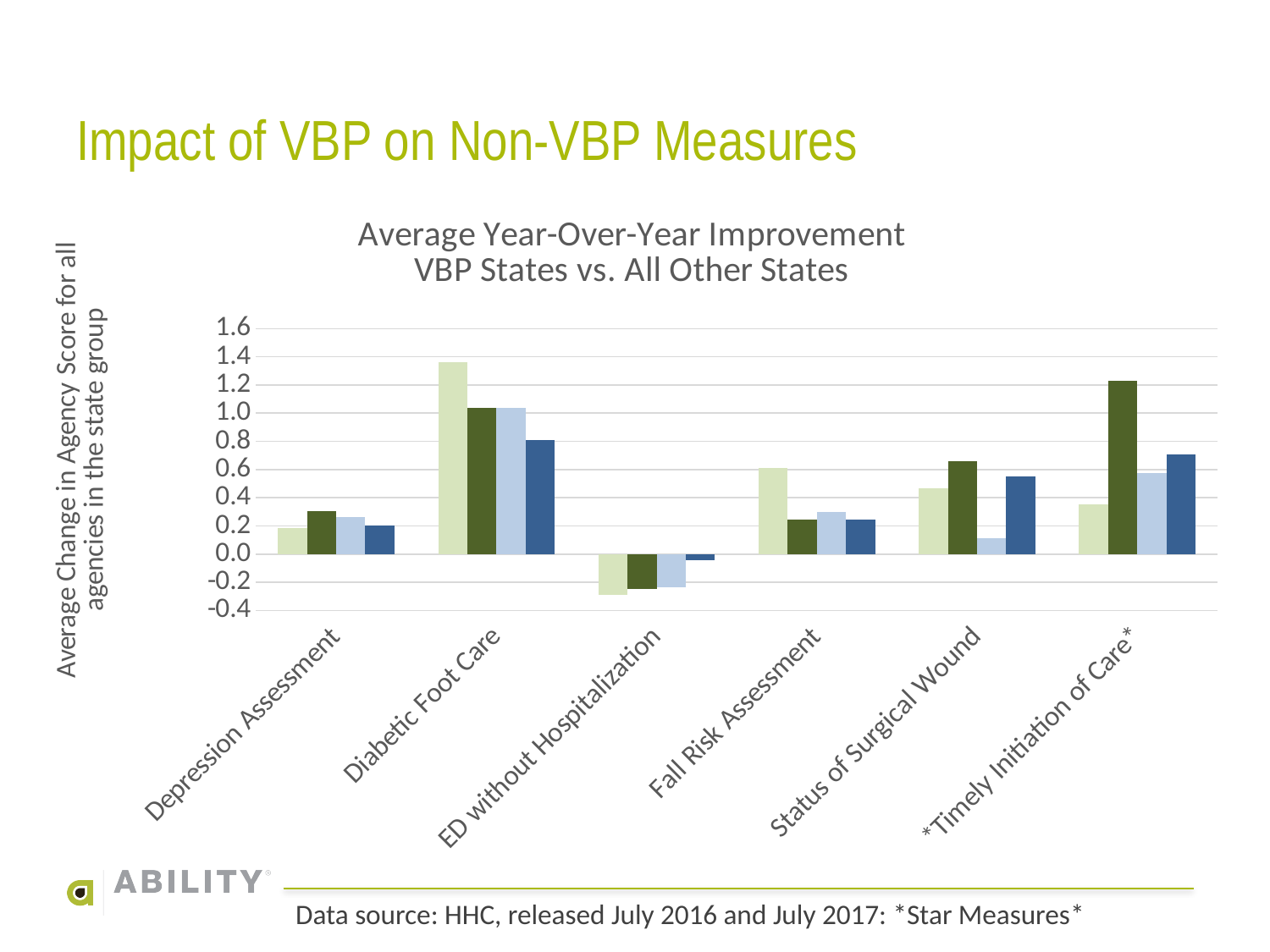
What is the label of the vertical axis? Average Change in Agency Score for all agencies in the state group For Status of Surgical Wound, which is larger: the light blue bar or the dark blue bar? the dark blue bar Is the dark green bar for *Timely Initiation of Care* greater or less than 1.0? greater Which category is the only one with bars below zero? ED without Hospitalization Is the light green bar for Diabetic Foot Care greater or less than 1.2? greater How many categories are shown on the x axis of the chart? 6 Which category contains the tallest bar in the chart? Diabetic Foot Care What is the title of the chart? Average Year-Over-Year Improvement VBP States vs. All Other States How many bars are plotted for each category in the chart? 4 What type of chart is shown on the slide? bar chart For Fall Risk Assessment, which is larger: the light green bar or the dark green bar? the light green bar Is the light green bar for Depression Assessment greater or less than 0.4? less